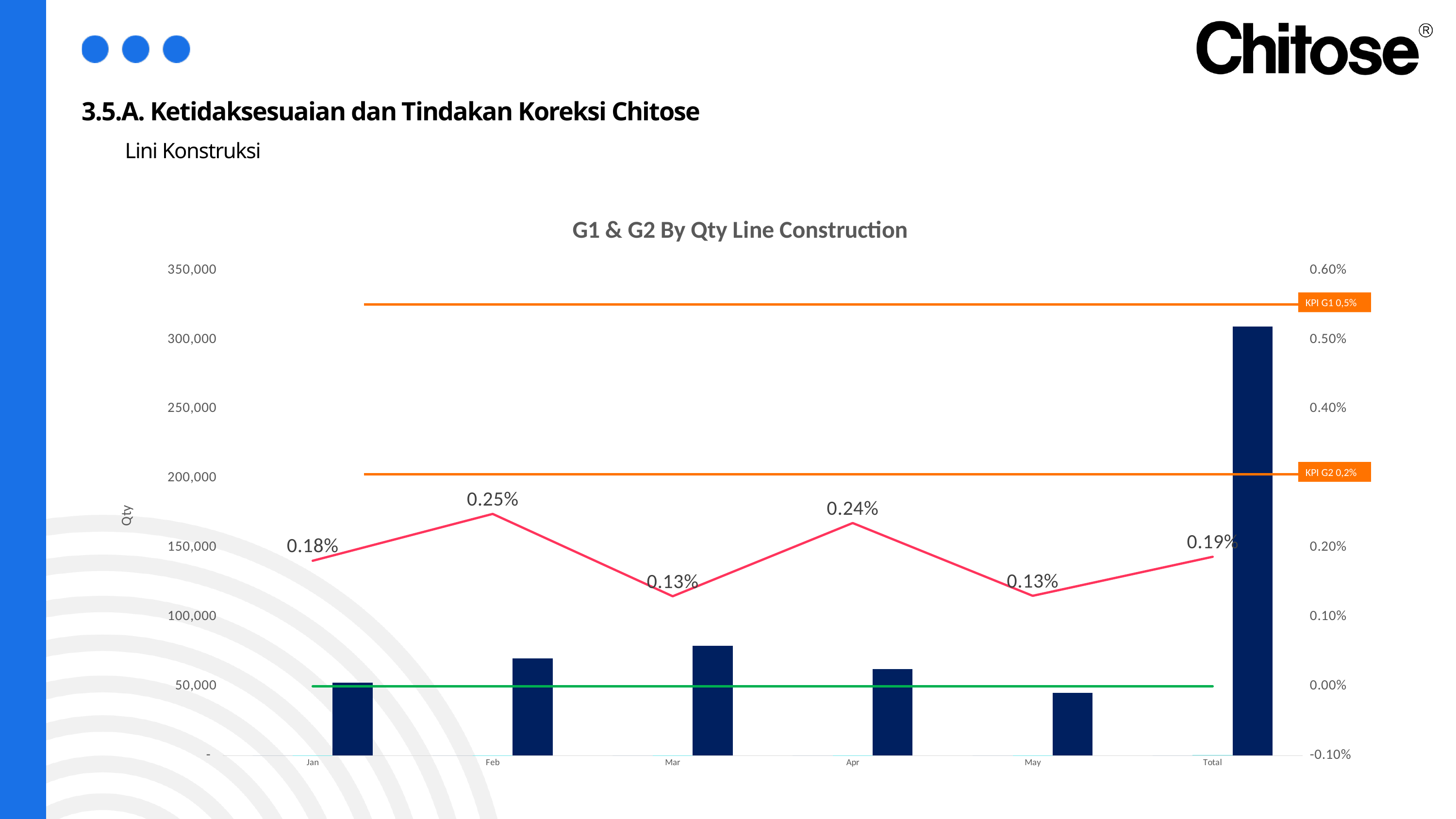
What is the difference between the percentage values for Feb and Mar? 0.12% What percentage value is labelled on the line for Feb? 0.25% What value is shown on the KPI G1 label? 0,5% Is the Qty bar for Total greater or less than 300,000? greater Is the Qty bar for May greater or less than 50,000? less What percentage value is labelled on the line for Total? 0.19% What is the title of the chart? G1 & G2 By Qty Line Construction Which has the larger percentage value on the line, Apr or Jan? Apr Is the Qty bar for Mar greater or less than 100,000? less What percentage value is labelled on the line for Jan? 0.18% Which category has the highest percentage value on the line? Feb How many categories are shown on the x axis? 6